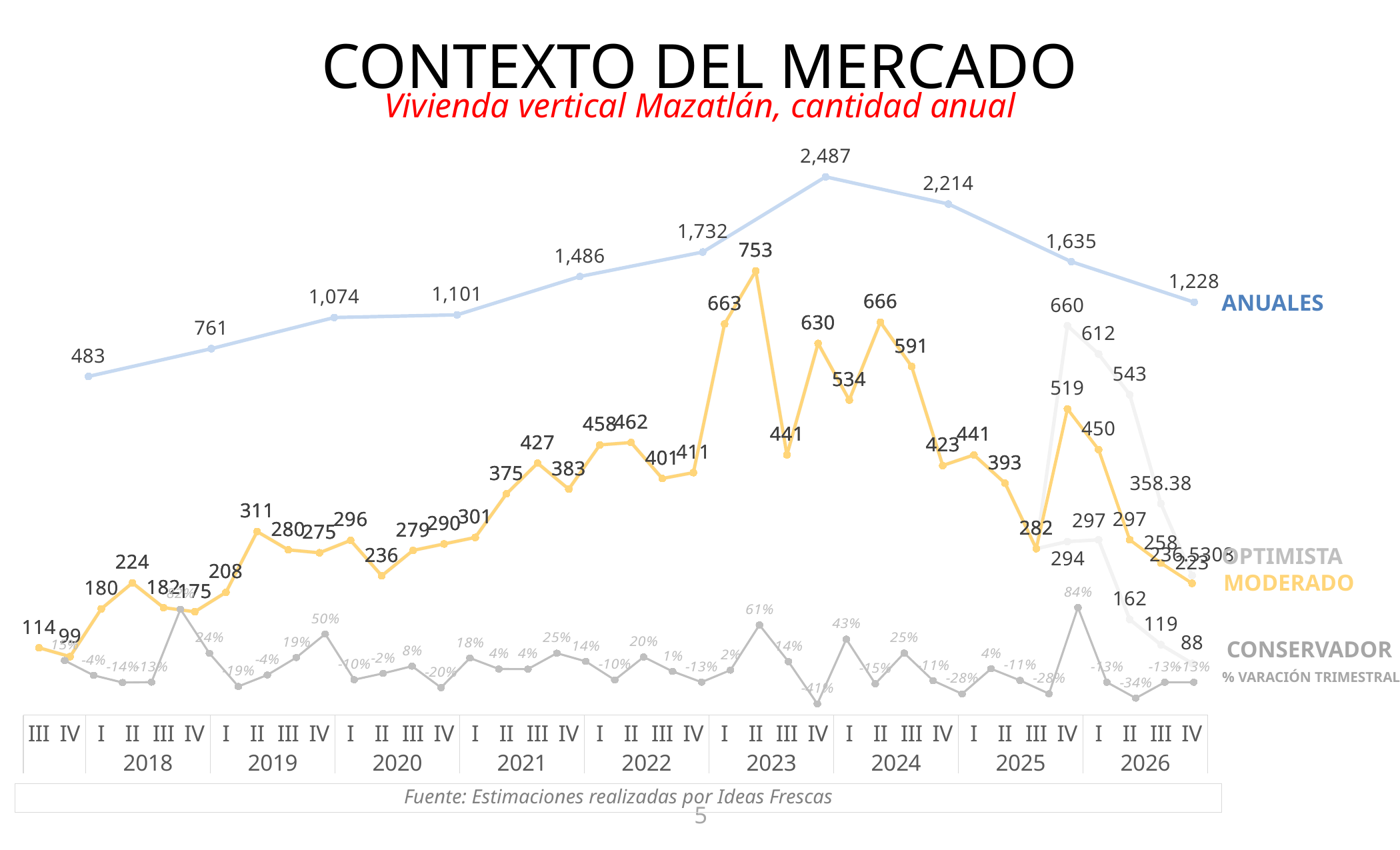
What is the ANUALES value for 2026? 1,228 What is the difference between the ANUALES values for 2022 and 2021? 246 Which year has the larger ANUALES value, 2019 or 2020? 2020 How many data points are plotted on the ANUALES line? 10 What kind of chart is shown on the slide? line chart What is the ANUALES value for 2025? 1,635 What is the highest value on the ANUALES line? 2,487 What is the source cited below the chart? Estimaciones realizadas por Ideas Frescas What is the highest value on the MODERADO line? 753 What is the lowest value on the ANUALES line? 483 Does the ANUALES line rise or fall from 2023 to 2026? fall What is the difference between the ANUALES values for 2023 and 2024? 273